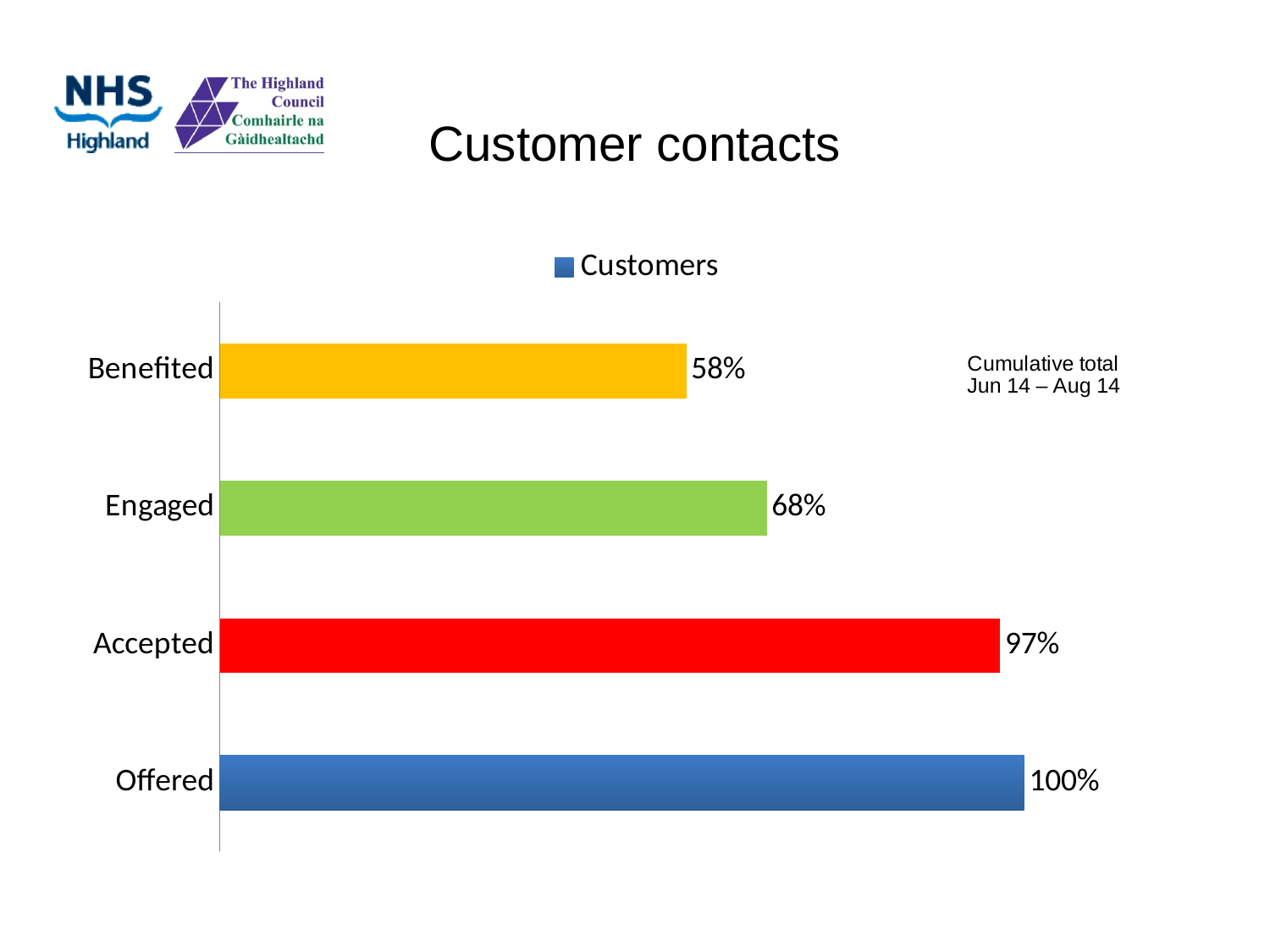
What is the value for Accepted? 97% Which category has the lowest value? Benefited What is the value for Benefited? 58% What kind of chart is shown on the slide? Bar chart How many series does the legend list? 1 Which is larger, the value for Engaged or the value for Benefited? Engaged What is the difference between the values for Engaged and Benefited? 10% What is the value for Offered? 100% What is the value for Engaged? 68% How many categories are shown in the chart? 4 What is the difference between the values for Accepted and Engaged? 29% Which category has the highest value? Offered